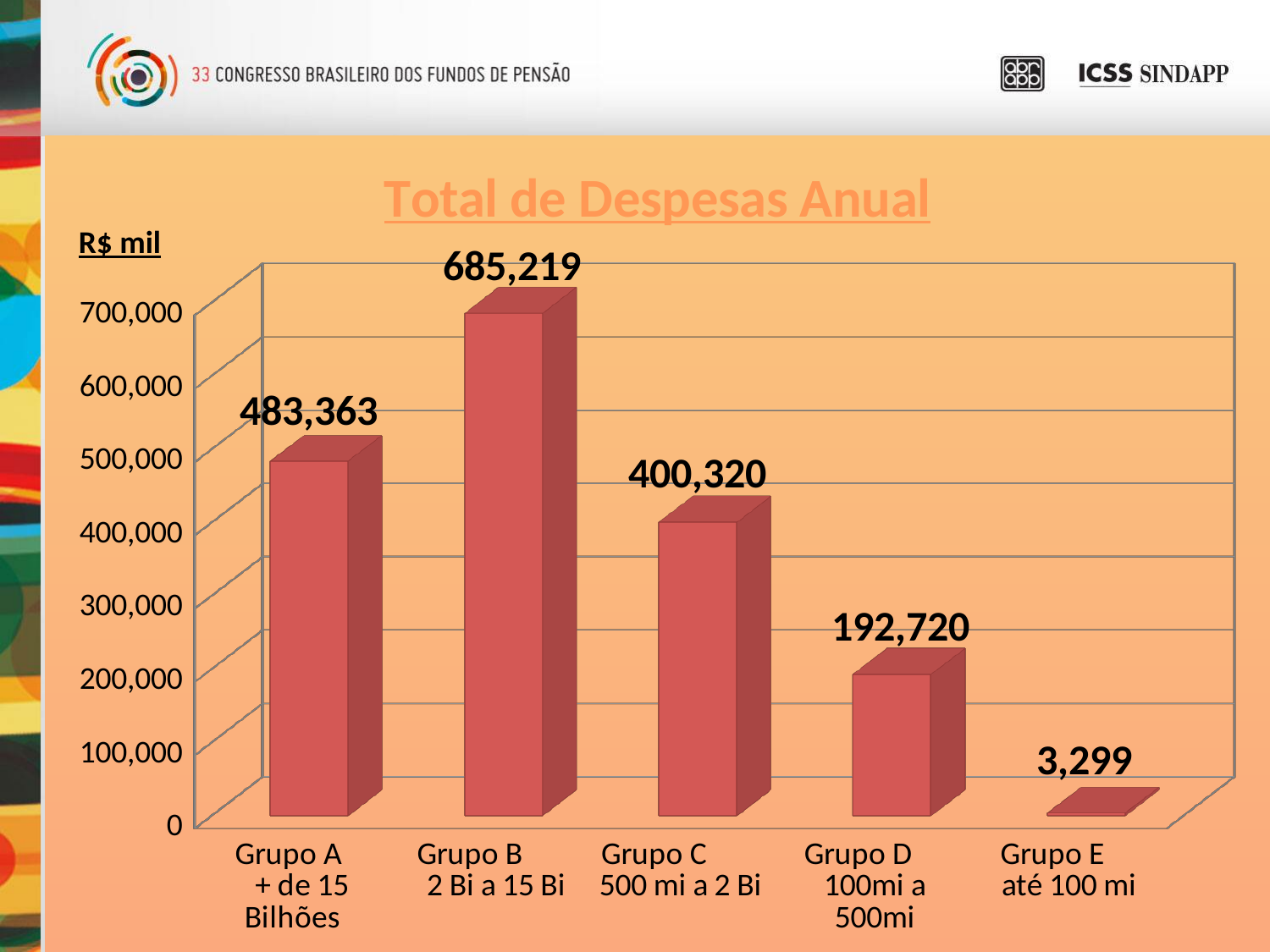
What is the difference between the values for Grupo B and Grupo A? 201,856 Is the value for Grupo A greater or less than 400,000? greater What kind of chart is shown on the slide? bar chart What is the difference between the values for Grupo C and Grupo D? 207,600 What is the value for Grupo D in the Total de Despesas Anual chart? 192,720 How many groups are shown in the chart? 5 What is the title of the chart? Total de Despesas Anual What is the value for Grupo B in the Total de Despesas Anual chart? 685,219 Which group has the lowest total annual expenses? Grupo E What is the value for Grupo E in the Total de Despesas Anual chart? 3,299 Which group has the highest total annual expenses? Grupo B Which is larger, the value for Grupo A or the value for Grupo C? Grupo A